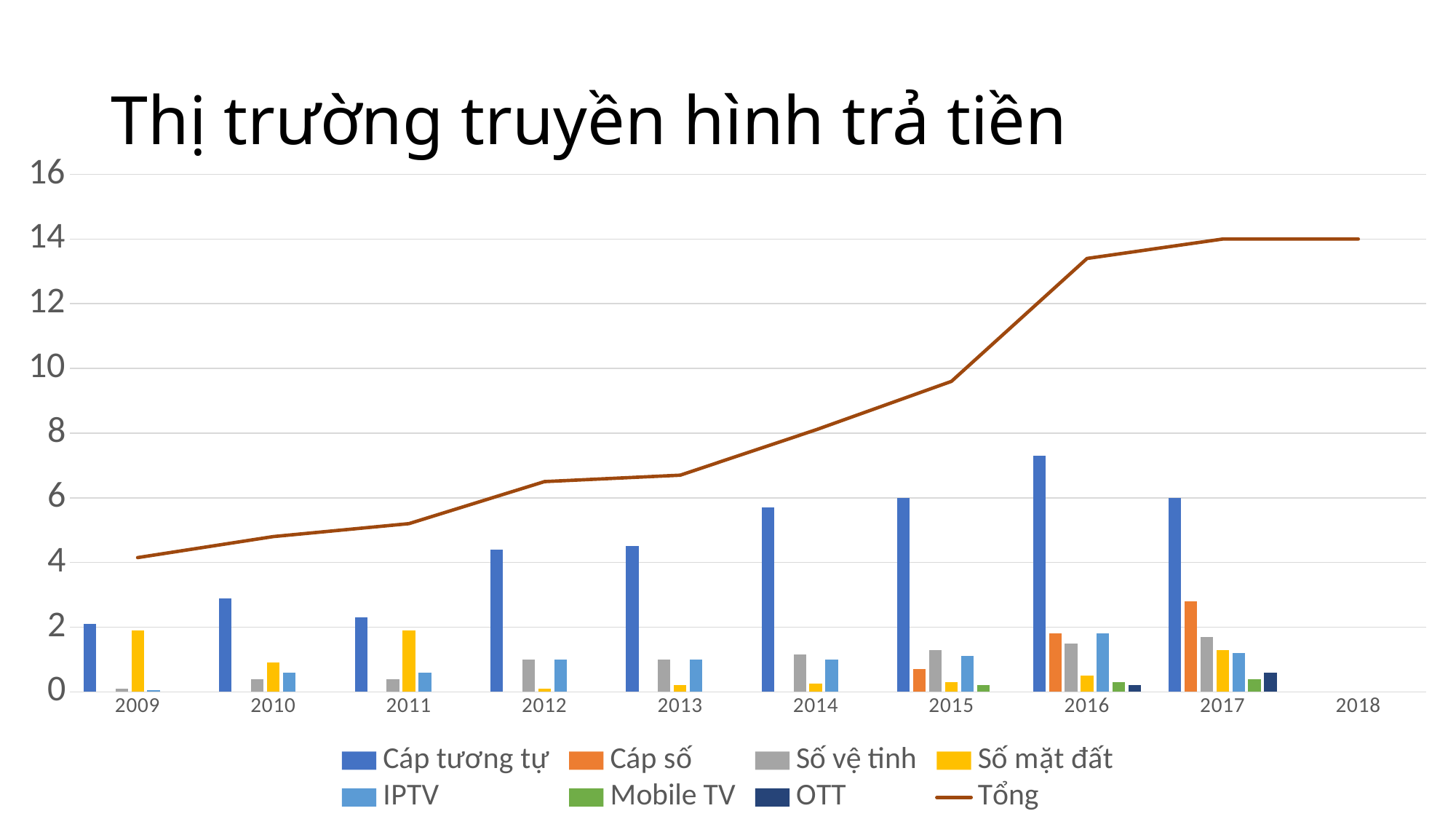
Which is larger, the Cáp tương tự bar in 2016 or in 2017? 2016 What kind of chart is this? A combined bar and line chart How many series does the legend list? 8 Is the value for Cáp tương tự in 2016 greater or less than 6? greater How many years are shown on the x axis? 10 In which year is the Cáp tương tự bar highest? 2016 Does the Tổng line rise or fall from 2009 to 2018? Rises What is the title of the chart? Thị trường truyền hình trả tiền What is the value of Tổng in 2018? 14 Is the value of Tổng in 2016 greater or less than 12? greater Is the value for Cáp số in 2017 greater or less than 2? greater